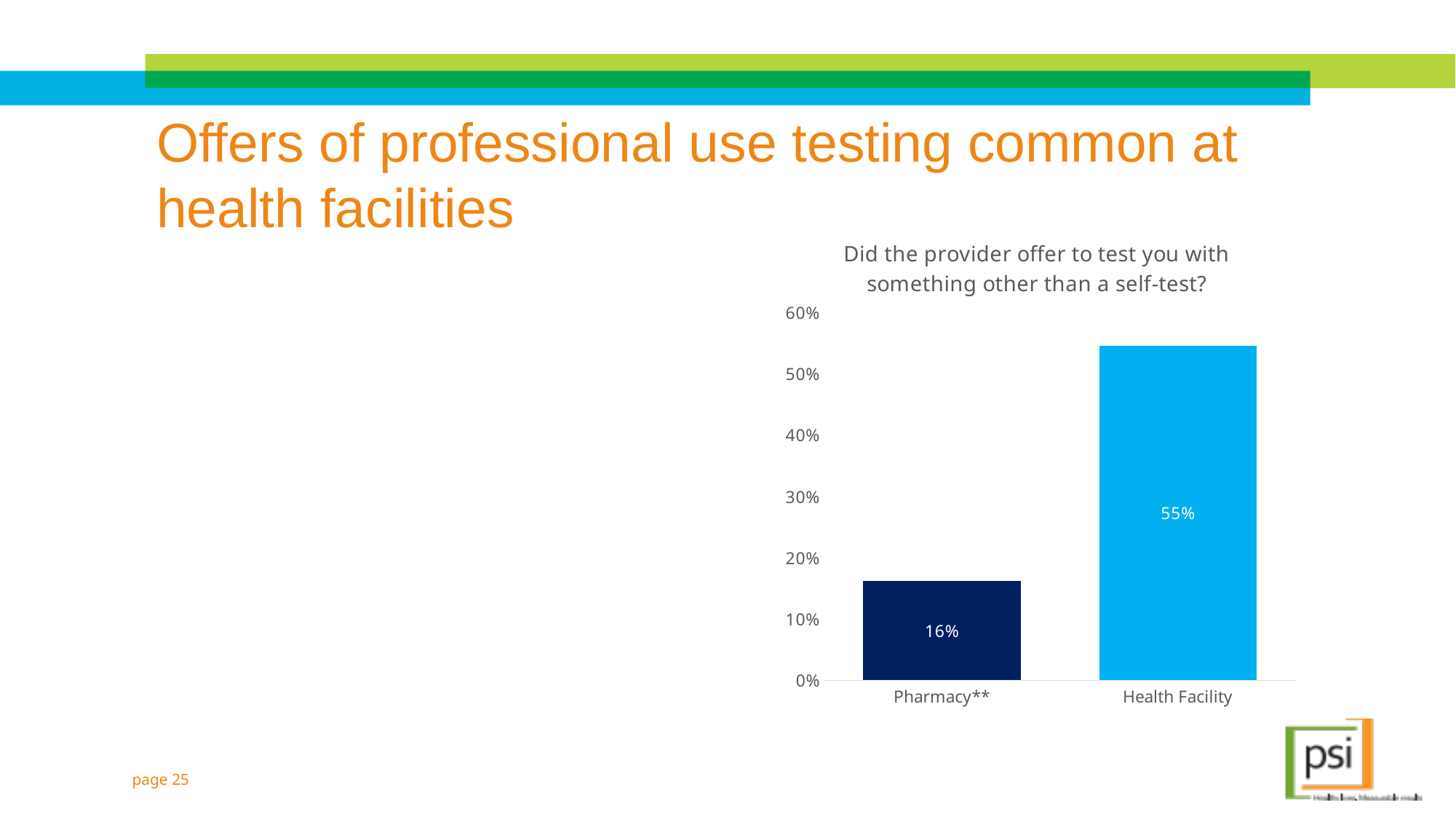
Is the value for Health Facility greater or less than 50%? greater Is the value for Pharmacy** greater or less than 20%? less What is the value for Pharmacy**? 16% How many categories are shown on the chart? 2 What is the difference between the values for Health Facility and Pharmacy**? 39% What is the title of the chart? Did the provider offer to test you with something other than a self-test? What kind of chart is shown on the slide? bar chart Which category has the lowest value? Pharmacy** What is the value for Health Facility? 55% What is the highest value shown on the vertical axis? 60% Which is larger, the value for Pharmacy** or the value for Health Facility? Health Facility Which category has the highest value? Health Facility